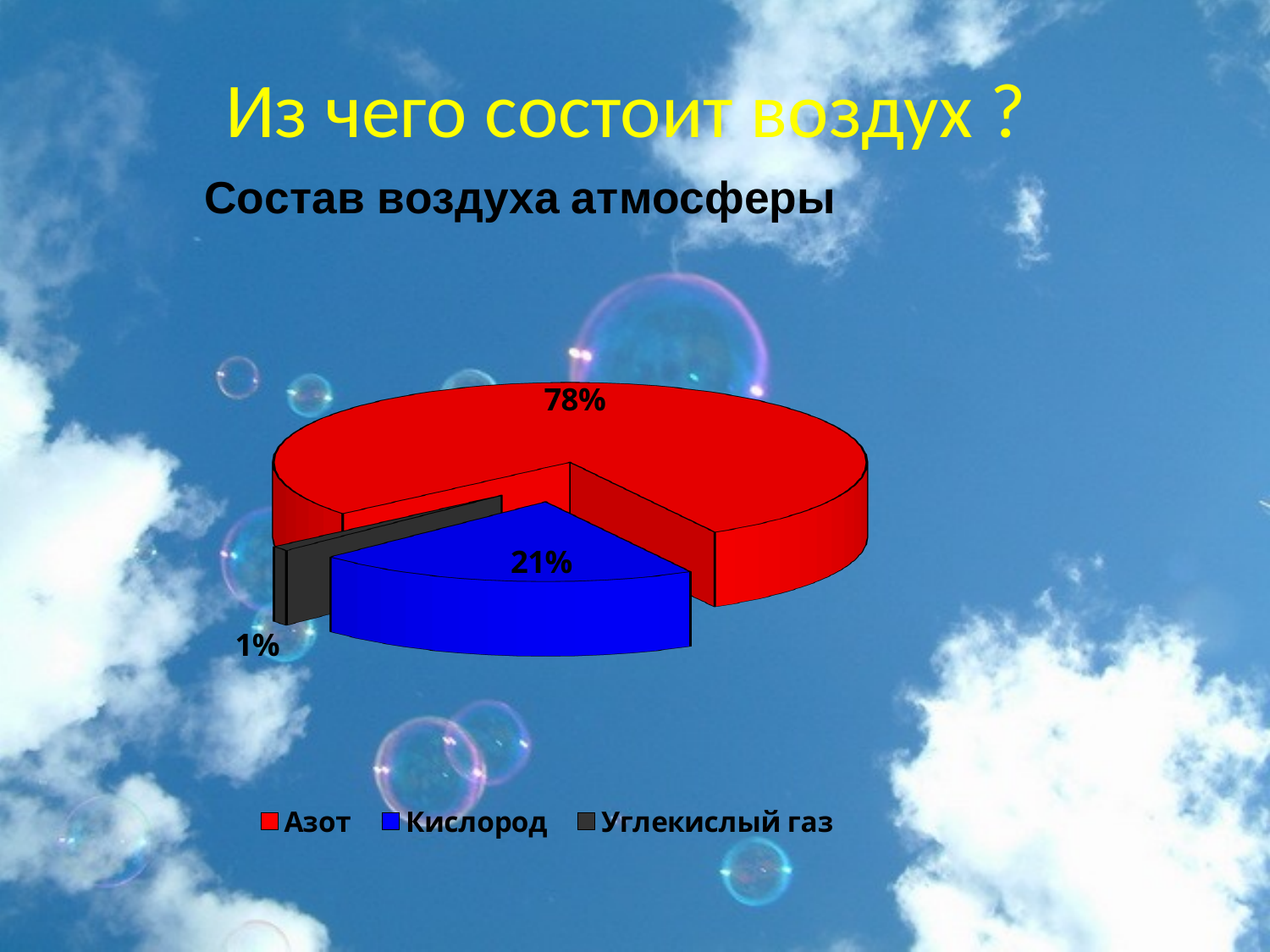
Which category has the largest slice of the pie? Азот What share of the pie does Кислород (oxygen) take? 21% What share of the pie does Углекислый газ (carbon dioxide) take? 1% How many entries does the legend list? 3 What kind of chart is shown on the slide? Pie chart What is the title of the chart? Состав воздуха атмосферы Which slice is larger, Кислород or Углекислый газ? Кислород How many slices does the pie chart have? 3 Which category has the smallest slice of the pie? Углекислый газ What share of the pie does Азот (nitrogen) take? 78% What is the difference in percentage points between the Азот and Кислород slices? 57% What colour represents Кислород in the chart? Blue